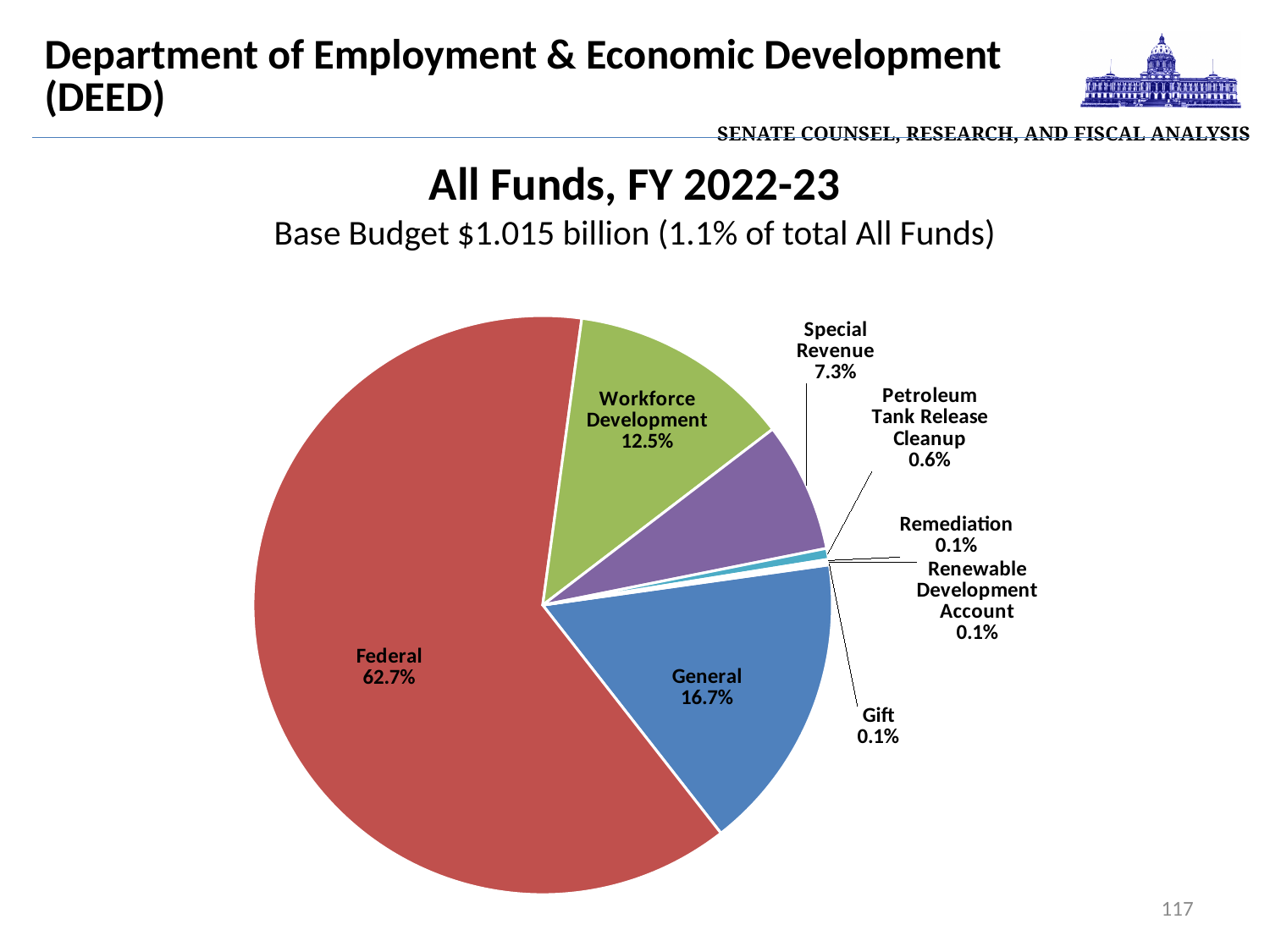
What share of All Funds does Federal account for? 62.7% What percentage of the pie is the General fund? 16.7% What type of chart is shown on the slide? Pie chart What share does Petroleum Tank Release Cleanup represent? 0.6% What is the title of the chart? All Funds, FY 2022-23 What percentage is shown for Special Revenue? 7.3% Which fund has the largest slice of the pie? Federal How many slices does the pie chart have? 8 What is the share for Workforce Development? 12.5% What is the difference in percentage points between Federal and General? 46.0% Which is larger, Workforce Development or Special Revenue? Workforce Development What is the combined share of General and Workforce Development? 29.2%